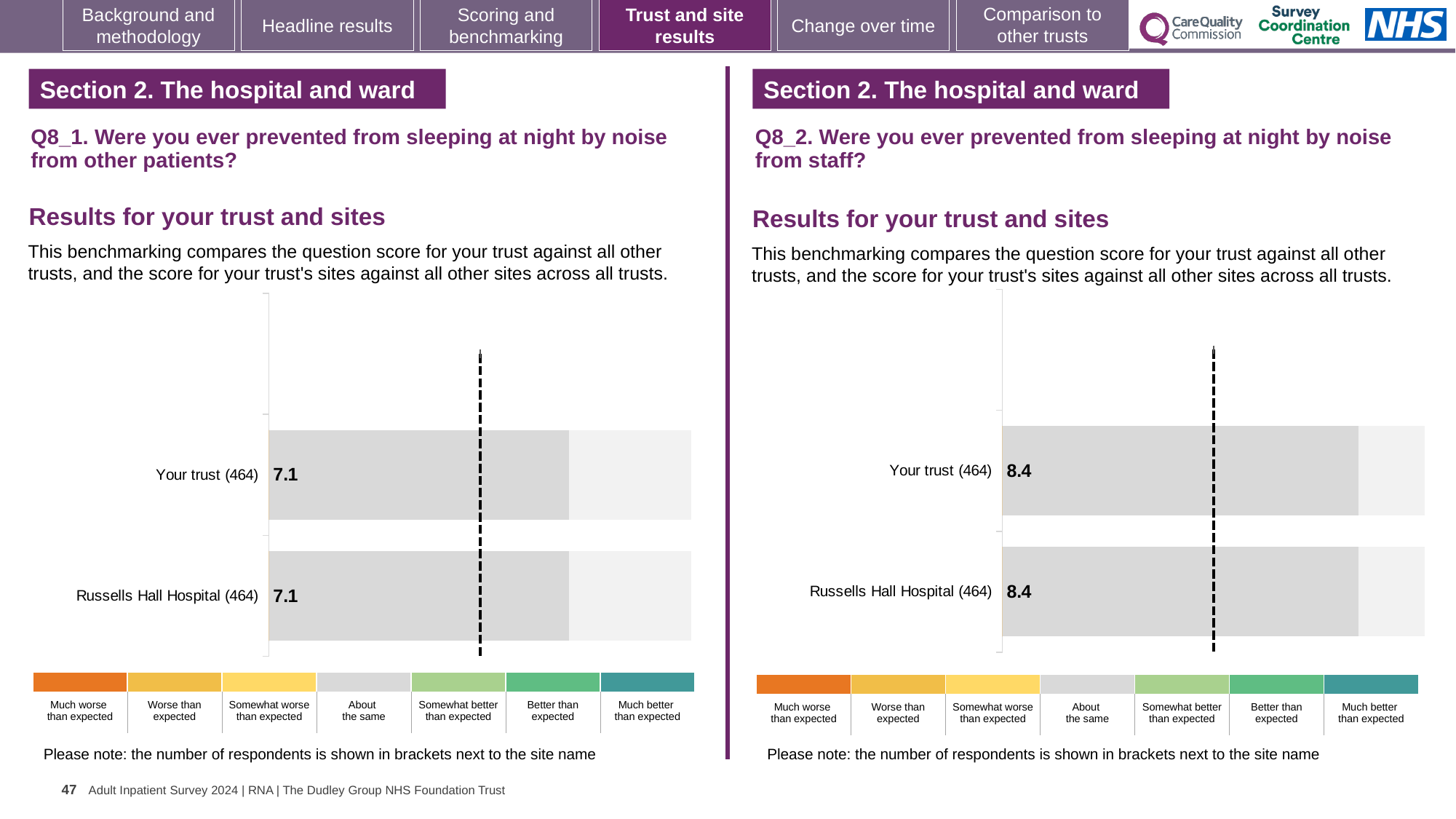
How many rating categories are shown in the colour key below the Q8_2 chart (right)? 7 Which is larger: the Your trust score in the Q8_2 chart (right) or the Your trust score in the Q8_1 chart (left)? Q8_2 (right) What kind of chart is used for the Q8_1 results (left)? Bar chart How many bars are plotted in the Q8_2 chart (right)? 2 In the Q8_1 chart (left), is the score for Russells Hall Hospital the same as the score for Your trust? Yes In the Q8_1 chart (left), what is the score for Russells Hall Hospital (464)? 7.1 In the Q8_1 chart (left), what is the score for Your trust (464)? 7.1 In the Q8_1 chart (left), how many respondents are shown in brackets next to Russells Hall Hospital? 464 In the Q8_2 chart (right), what is the score for Russells Hall Hospital (464)? 8.4 How many bars are plotted in the Q8_1 chart (left)? 2 In the Q8_2 chart (right), what is the score for Your trust (464)? 8.4 What is the difference between the Your trust score in the Q8_2 chart (right) and the Your trust score in the Q8_1 chart (left)? 1.3